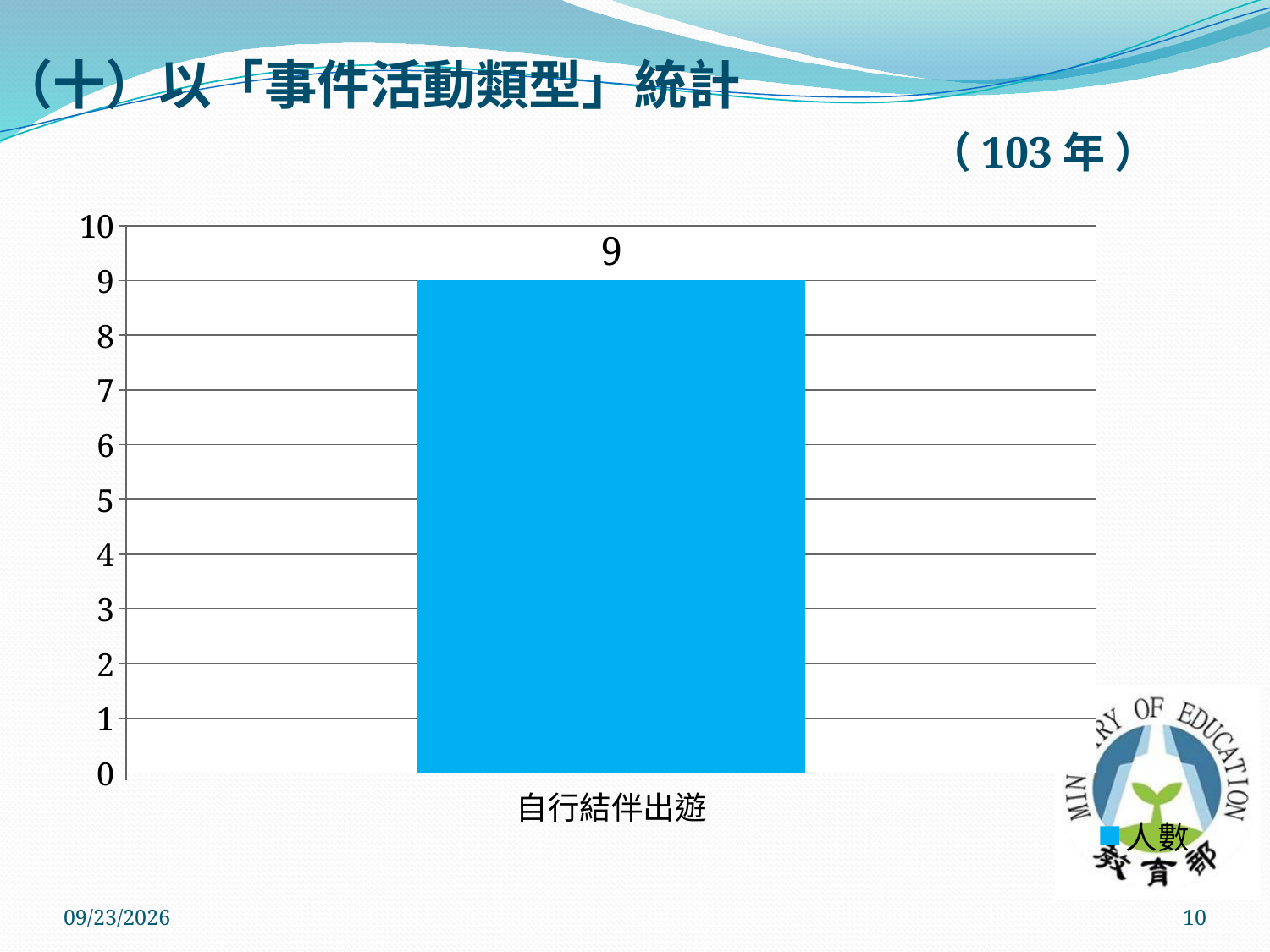
How many categories are shown on the x axis? 1 Which category has the highest value? 自行結伴出遊 Is the value for 自行結伴出遊 greater or less than 10? less How many series does the legend list? 1 What is the value for 自行結伴出遊? 9 What kind of chart is shown on the slide? bar chart Is the value for 自行結伴出遊 greater or less than 5? greater What is the maximum value shown on the y axis? 10 What is the name of the series in the legend? 人數